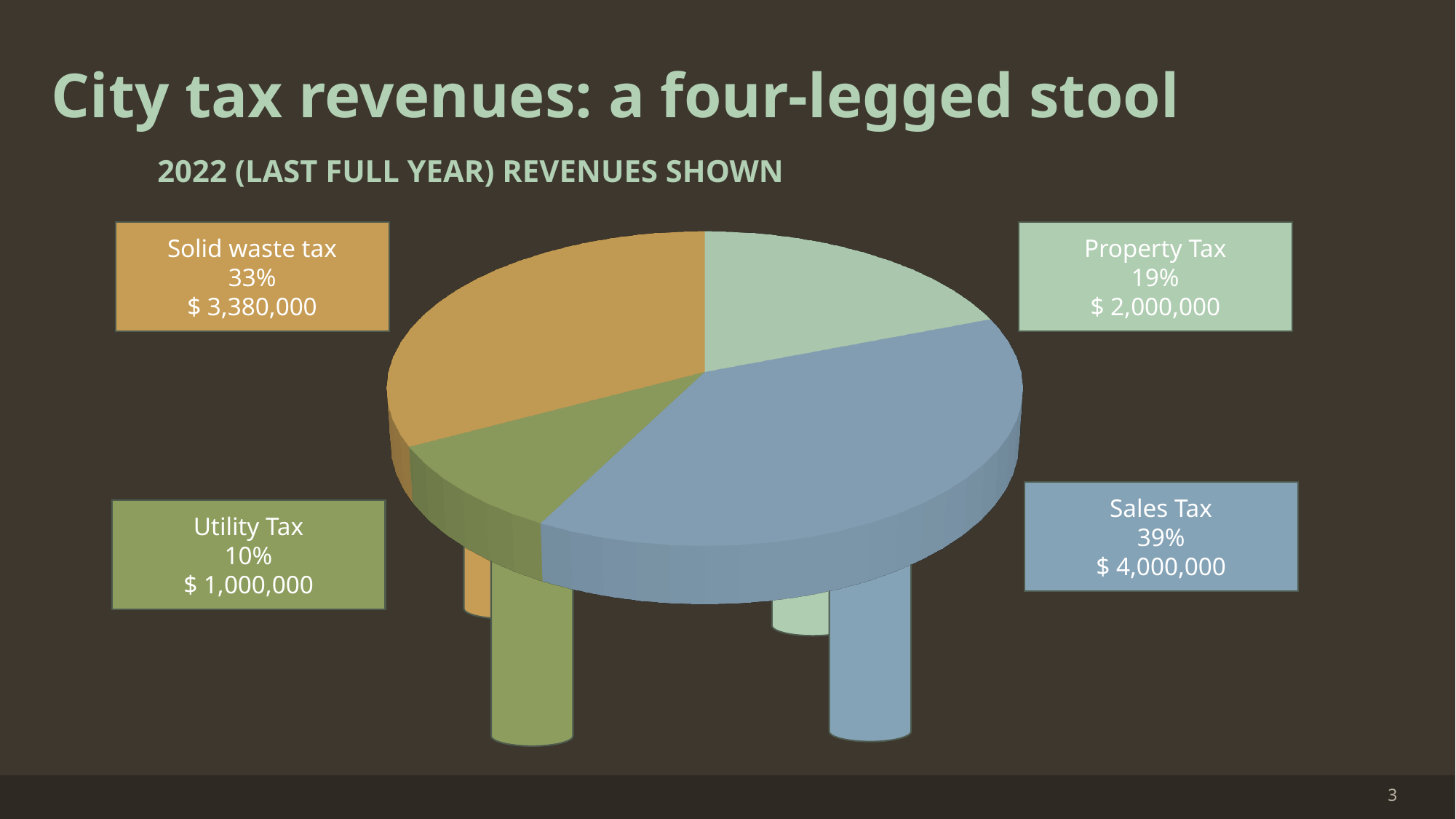
What kind of chart is shown on the slide? pie chart Which tax category has the largest share of revenues? Sales Tax What is the difference in revenue between Sales Tax and Property Tax? $ 2,000,000 How many tax categories are shown in the pie chart? 4 Which is larger, the revenue from Solid waste tax or from Property Tax? Solid waste tax What is the difference in percentage share between Solid waste tax and Utility Tax? 23% What is the revenue amount shown for Solid waste tax? $ 3,380,000 Which tax category has the smallest share of revenues? Utility Tax Which year's revenues are shown in the chart? 2022 What share of revenues does Utility Tax represent? 10% What is the revenue amount shown for Property Tax? $ 2,000,000 What share of city tax revenues does Sales Tax represent? 39%